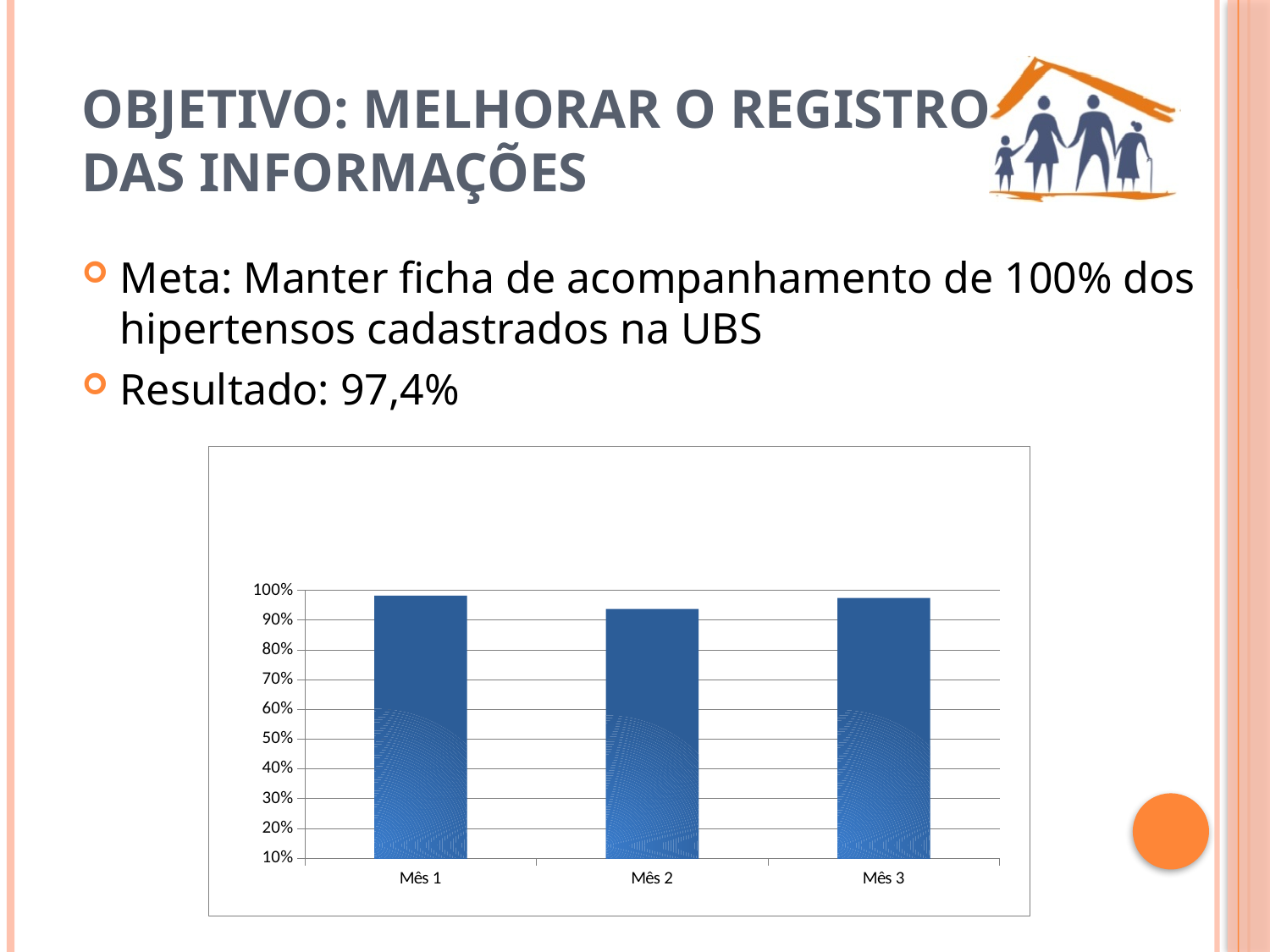
What kind of chart is shown on the slide? bar chart Which is larger, the value for Mês 2 or the value for Mês 3? Mês 3 Is the value for Mês 2 greater or less than 90%? greater Does the value rise or fall from Mês 1 to Mês 2? fall How many categories (months) are plotted on the chart? 3 What is the lowest tick label shown on the vertical axis of the chart? 10% Is the value for Mês 1 greater or less than 90%? greater Is the value for Mês 3 greater or less than 80%? greater What is the highest tick label shown on the vertical axis of the chart? 100% Which month has the lowest bar on the chart? Mês 2 Which is larger, the value for Mês 1 or the value for Mês 2? Mês 1